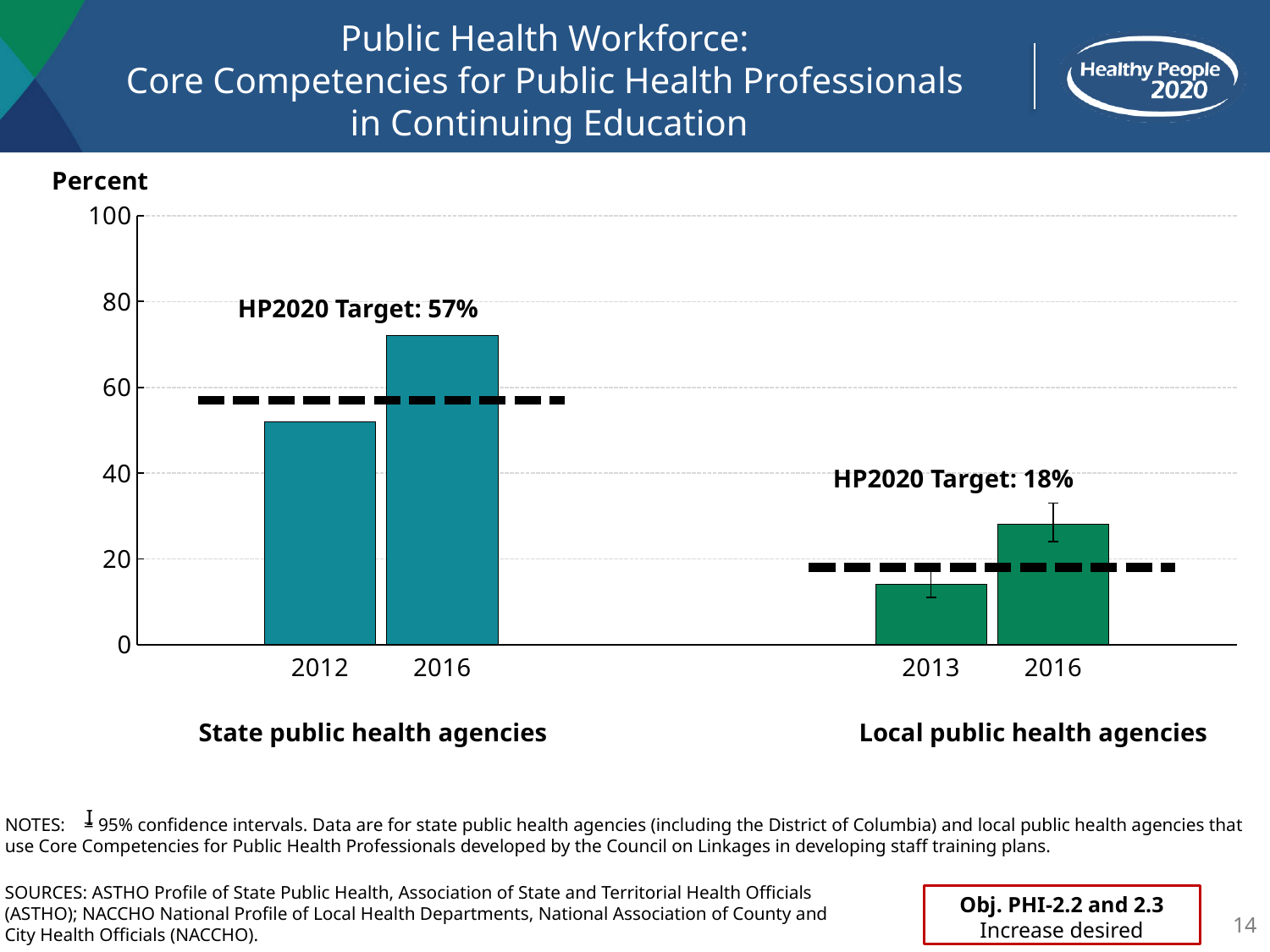
Is the value for state public health agencies in 2016 greater or less than 60? greater What kind of chart is shown on the slide? bar chart Which bar has the highest value in the chart? State public health agencies, 2016 Is the value for local public health agencies in 2016 greater or less than 20? greater Which bar has the lowest value in the chart? Local public health agencies, 2013 Did the value for local public health agencies rise or fall from 2013 to 2016? rise Which is larger: the value for state public health agencies in 2012 or in 2016? 2016 Is the value for local public health agencies in 2013 greater or less than 20? less What is the HP2020 Target shown for state public health agencies? 57% What is the HP2020 Target shown for local public health agencies? 18% How many bars are plotted in the chart? 4